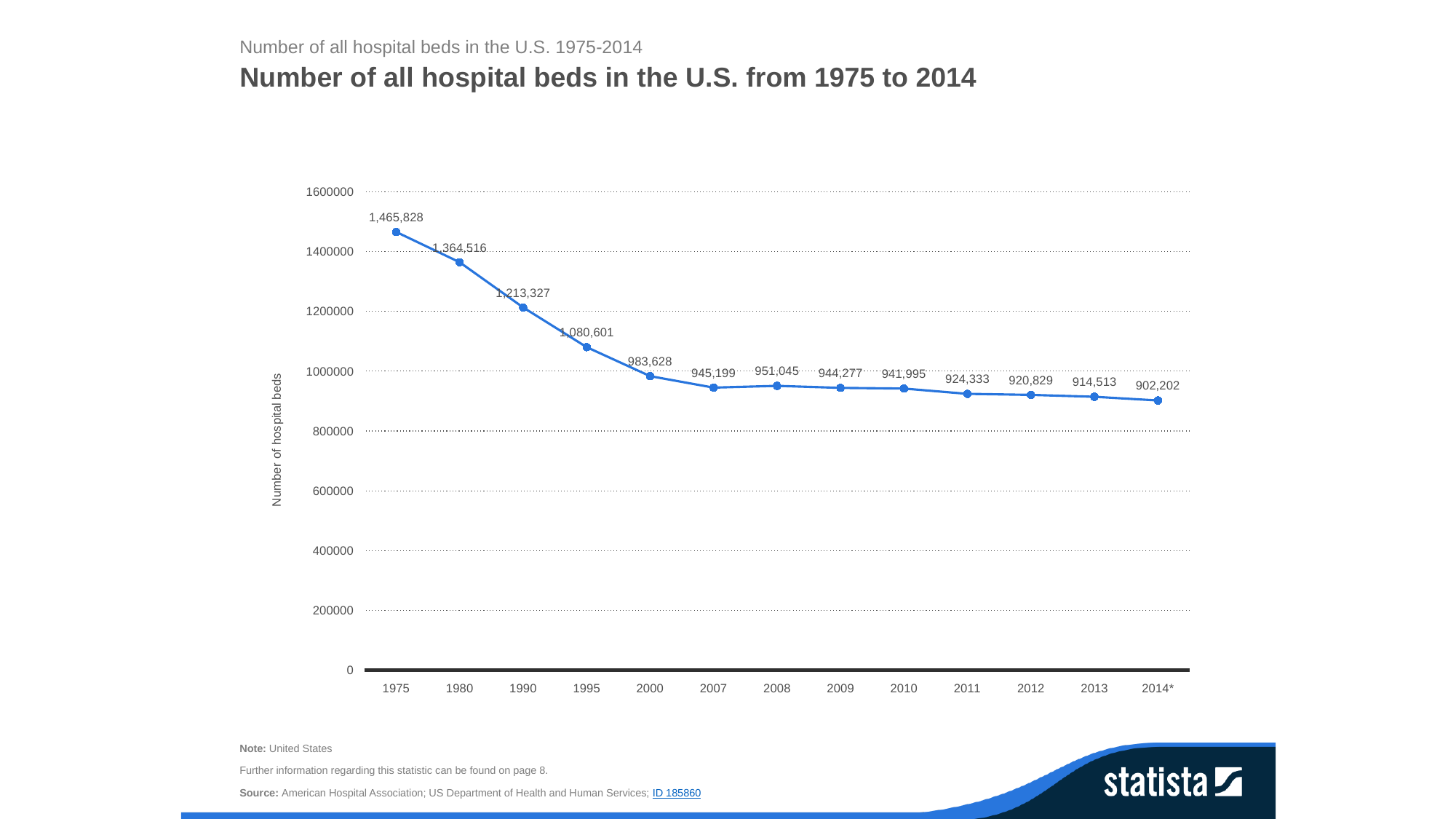
What is the number of hospital beds in the U.S. in 2008? 951,045 Does the number of hospital beds generally rise or fall from 1975 to 2014? Fall Which year has the highest number of hospital beds? 1975 What is the number of hospital beds in the U.S. in 1975? 1,465,828 What is the number of hospital beds in the U.S. in 2000? 983,628 What is the difference in the number of hospital beds between 1975 and 2014*? 563,626 What is the number of hospital beds in the U.S. in 2014*? 902,202 What is the difference in the number of hospital beds between 2013 and 2014*? 12,311 How many years are plotted on the chart? 13 Which year has the lowest number of hospital beds? 2014* Which year has more hospital beds, 2007 or 2008? 2008 What kind of chart is shown on the slide? Line chart